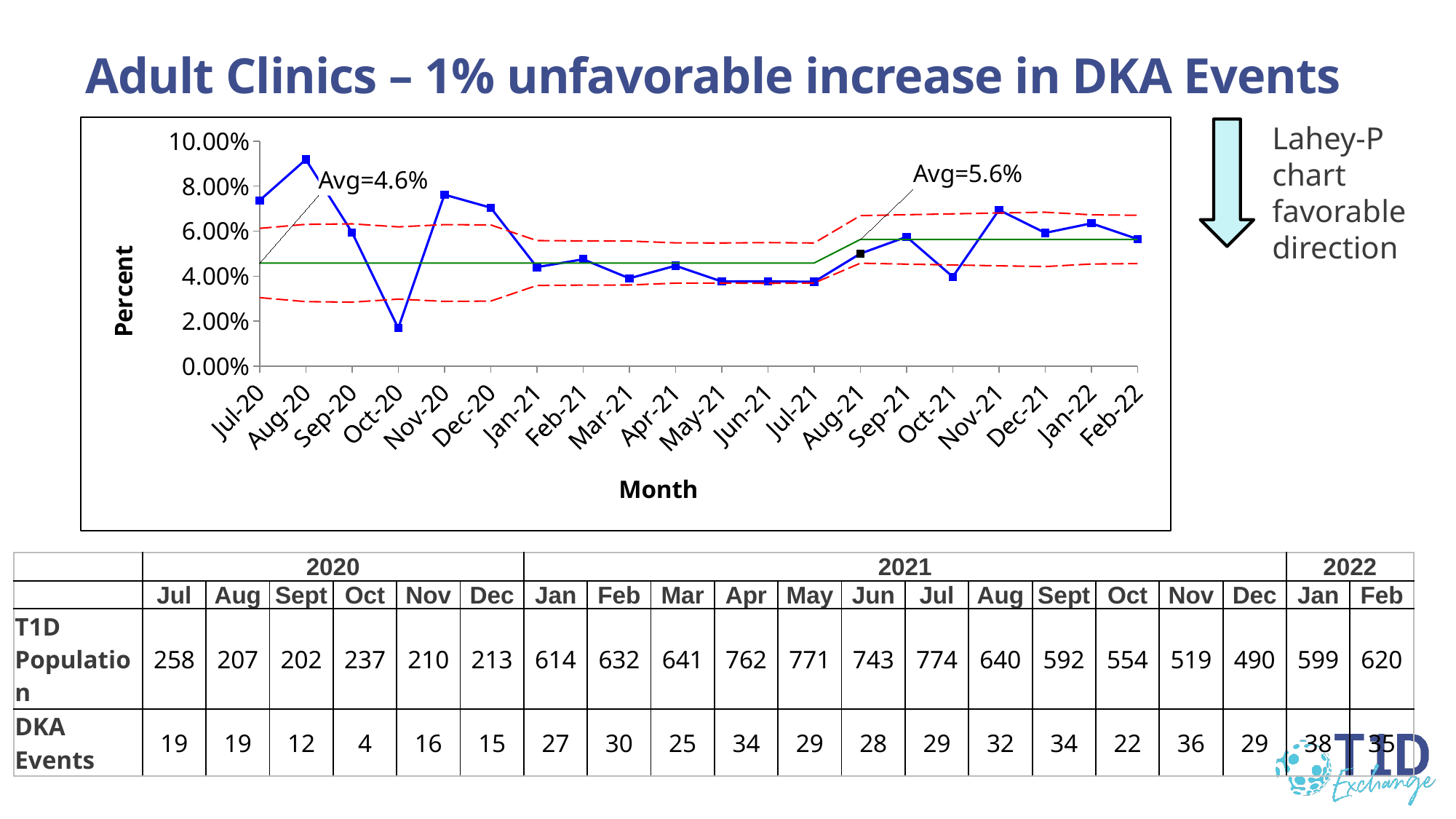
Which month has the lowest plotted DKA percentage? Oct-20 What kind of chart is shown on the slide? line chart Which month has the highest plotted DKA percentage? Aug-20 Which is larger, the value for Nov-20 or the value for Jan-21? Nov-20 Is the value for Nov-21 greater or less than 6.00%? greater What is the average value annotated for the first segment of the chart? Avg=4.6% How many months are plotted along the x axis of the chart? 20 What is the difference between the two annotated averages (5.6% and 4.6%)? 1.0% What is the average value annotated for the second segment of the chart? Avg=5.6% Is the value for Aug-20 greater or less than 8.00%? greater What is the label on the y axis of the chart? Percent Is the value for Oct-20 greater or less than 2.00%? less